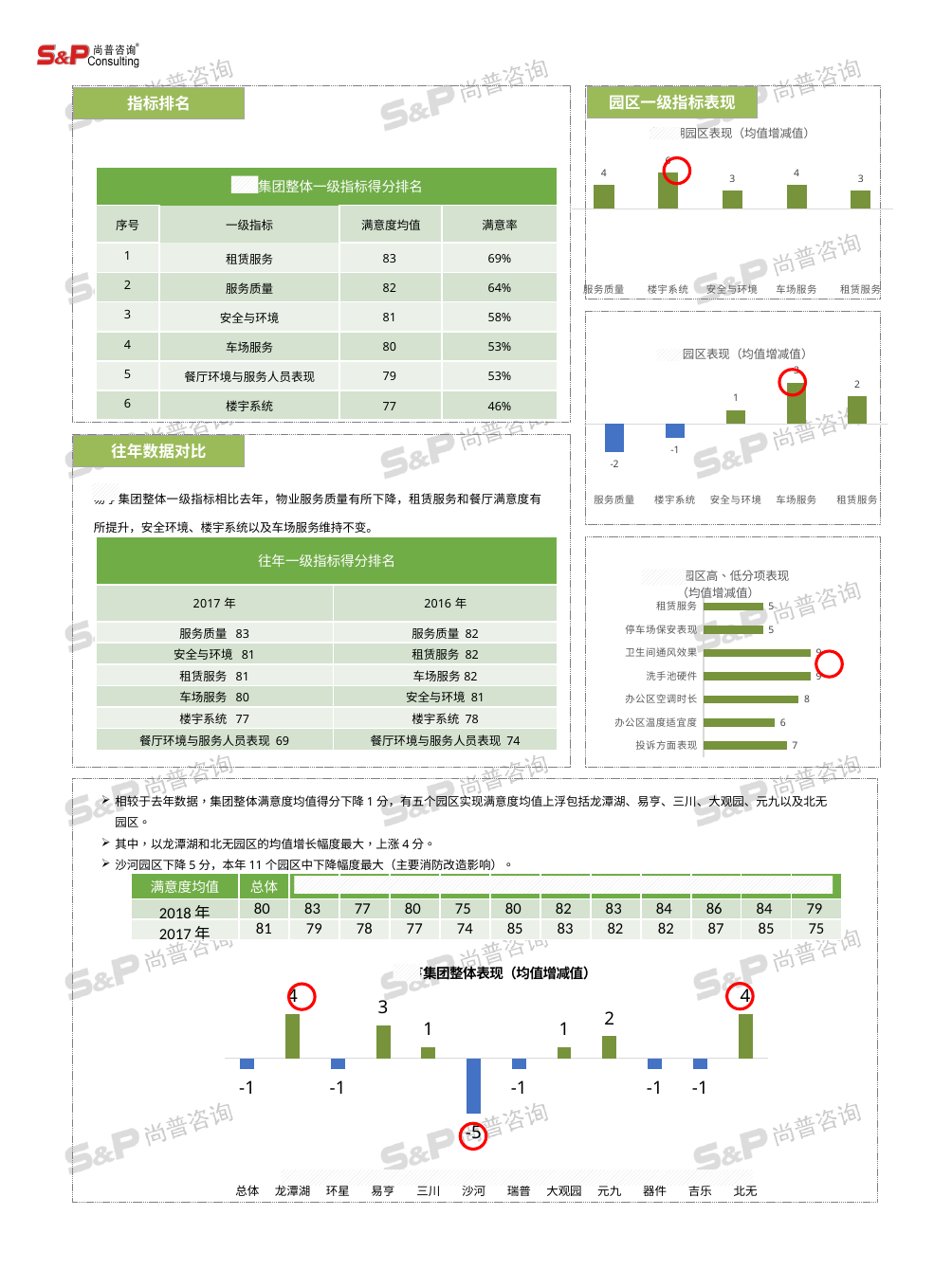
In the bottom chart (集团整体表现（均值增减值）), what kind of chart is it? bar chart In the bottom chart (集团整体表现（均值增减值）), how many categories are shown on the x axis? 12 In the bottom-right horizontal bar chart (园区高、低分项表现), what is the value for 办公区空调时长? 8 In the top-right chart, which category has the highest value? 楼宇系统 In the bottom chart (集团整体表现（均值增减值）), which category has the lowest value? 沙河 In the bottom chart (集团整体表现（均值增减值）), what is the difference between the values for 易亨 and 元九? 1 In the bottom chart (集团整体表现（均值增减值）), what is the value for 沙河? -5 In the middle-right chart (园区表现（均值增减值）), what is the value for 服务质量? -2 In the middle-right chart (园区表现（均值增减值）), which category has the highest value? 车场服务 In the bottom chart (集团整体表现（均值增减值）), which is larger, the value for 易亨 or the value for 三川? 易亨 In the bottom chart (集团整体表现（均值增减值）), what is the value for 龙潭湖? 4